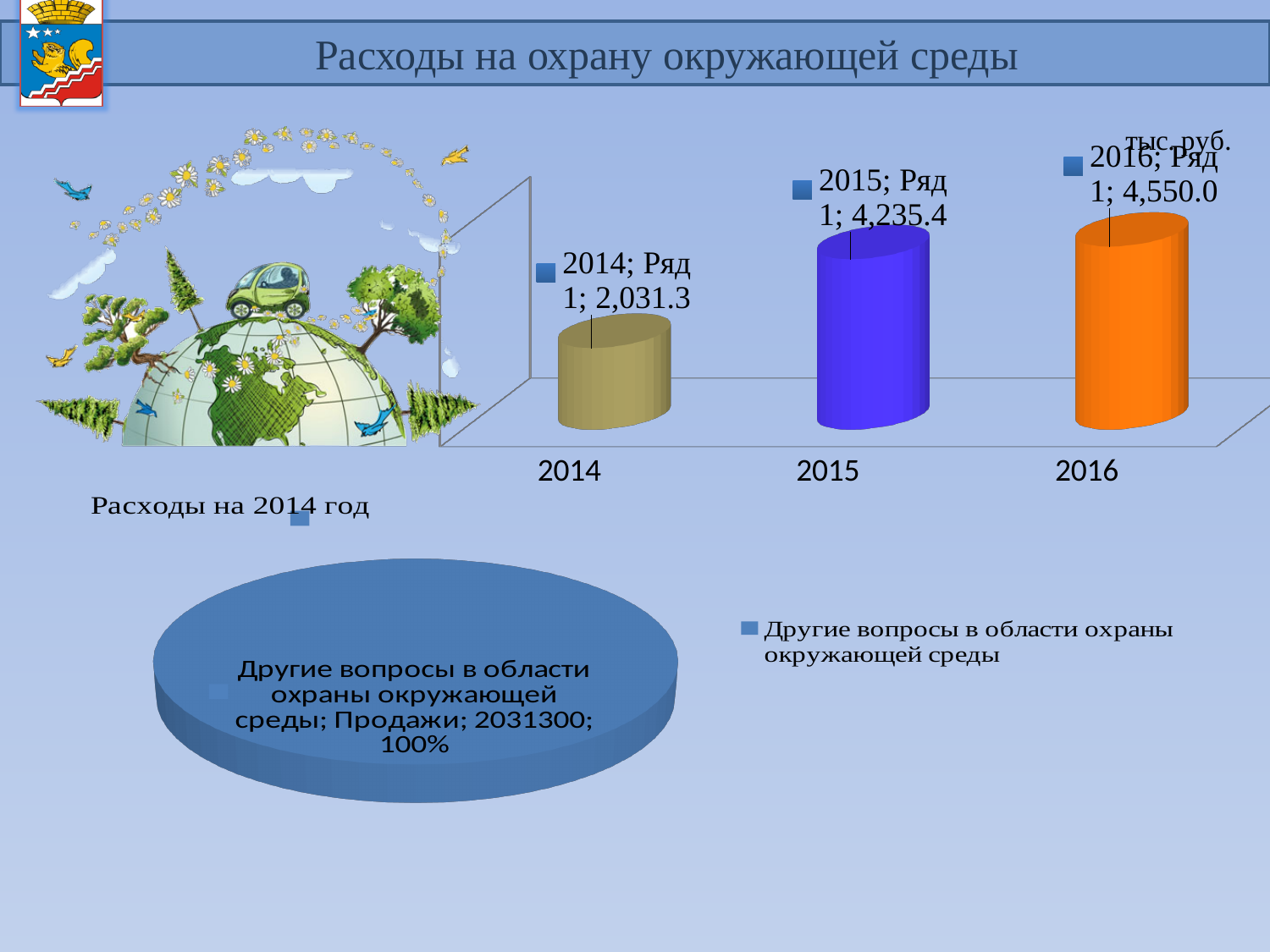
In the bar chart at the top of the slide, what is the difference between the values for 2016 and 2015? 314.6 In the bar chart at the top of the slide, what is the value for 2014? 2,031.3 In the bar chart at the top of the slide, do the values rise or fall from 2014 to 2016? rise In the bar chart at the top of the slide, what is the value for 2015? 4,235.4 In the bar chart at the top of the slide, what is the value for 2016? 4,550.0 In the pie chart titled 'Расходы на 2014 год', what share does the slice 'Другие вопросы в области охраны окружающей среды' have? 100% In the bar chart at the top of the slide, what is the difference between the values for 2015 and 2014? 2,204.1 In the bar chart at the top of the slide, which year has the lowest value? 2014 In the pie chart titled 'Расходы на 2014 год', what value is shown for 'Другие вопросы в области охраны окружающей среды'? 2031300 In the bar chart at the top of the slide, how many years are shown? 3 In the bar chart at the top of the slide, which year has the highest value? 2016 In the bar chart at the top of the slide, which is larger, the value for 2014 or the value for 2015? 2015